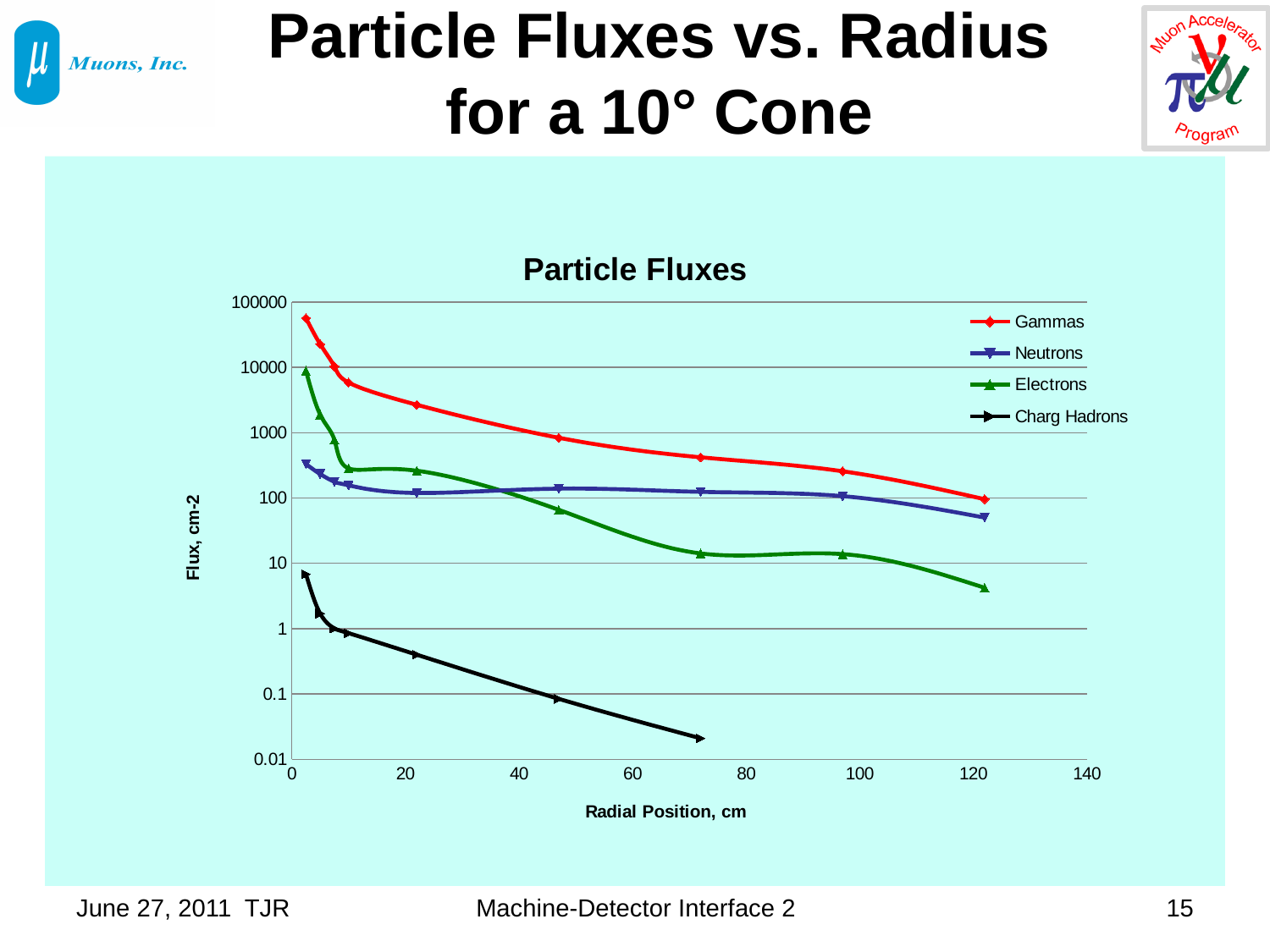
What is the title of the chart? Particle Fluxes Is the Charg Hadrons flux at a radial position of about 70 cm greater or less than 0.1? less Which series has the highest flux across the radial positions? Gammas Is the Electrons flux at a radial position of about 120 cm greater or less than 10? less At a radial position of about 120 cm, which is larger, the Gammas flux or the Electrons flux? Gammas What is the label of the x axis? Radial Position, cm Does the Gammas flux rise or fall as radial position increases? fall How many series does the legend list? 4 What kind of chart is shown on the slide? line chart Which series has the lowest flux across the radial positions? Charg Hadrons Is the Neutrons flux at a radial position of about 120 cm greater or less than 100? less Does the Charg Hadrons flux rise or fall as radial position increases? fall